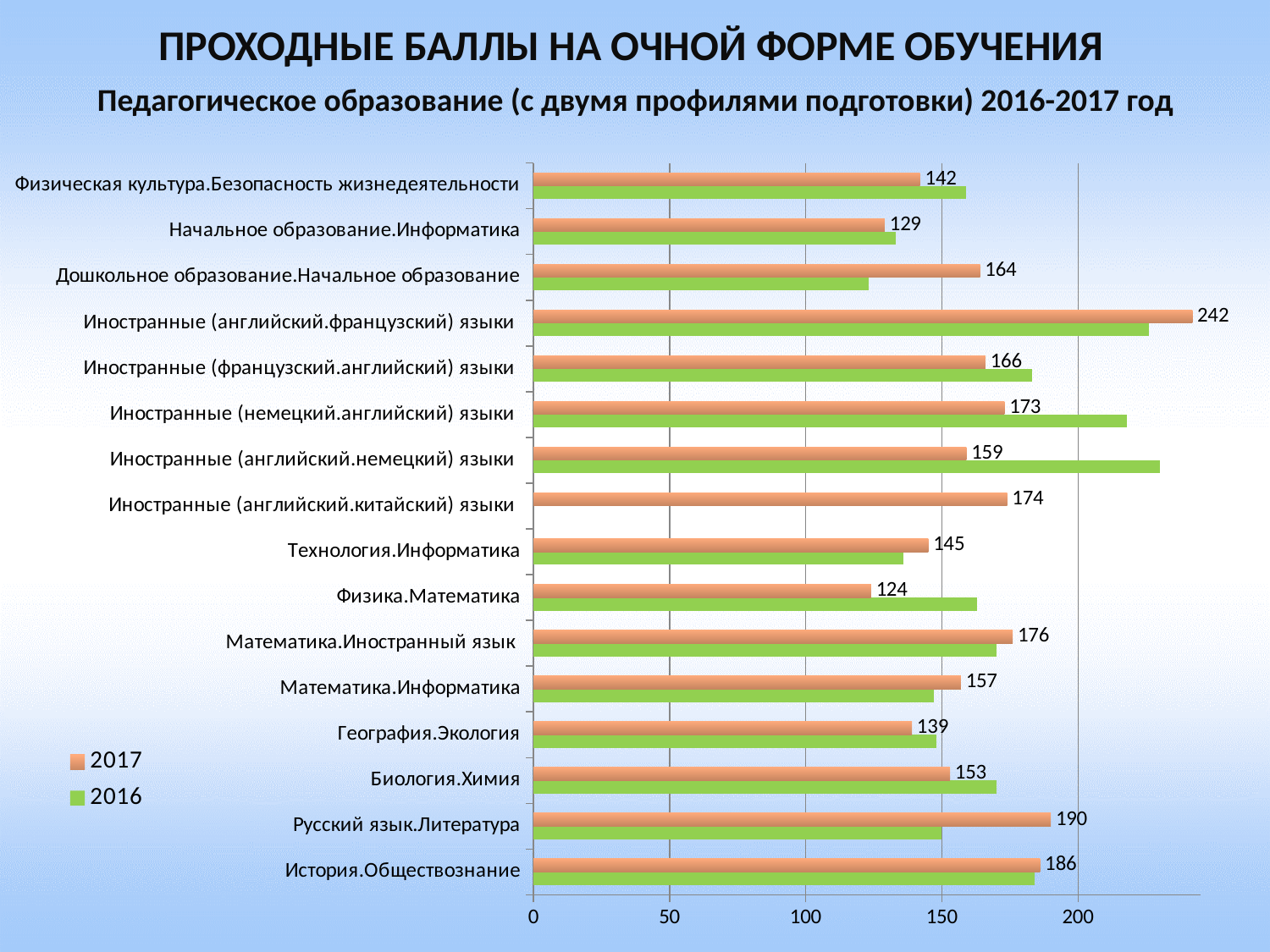
What is the difference between the 2017 values for Русский язык.Литература and История.Обществознание? 4 How many categories are shown on the chart? 16 What is the difference between the 2017 values for Математика.Иностранный язык and Математика.Информатика? 19 How many series does the legend list? 2 Is the 2016 value for Дошкольное образование.Начальное образование greater or less than 150? less Which category has the highest 2017 value? Иностранные (английский.французский) языки What is the 2017 value for Физика.Математика? 124 Is the 2016 value for Иностранные (английский.немецкий) языки greater or less than 200? greater Which category has the lowest 2017 value? Физика.Математика What is the 2017 value for Русский язык.Литература? 190 Which has the larger 2017 value: Биология.Химия or География.Экология? Биология.Химия What is the 2017 value for Иностранные (английский.французский) языки? 242